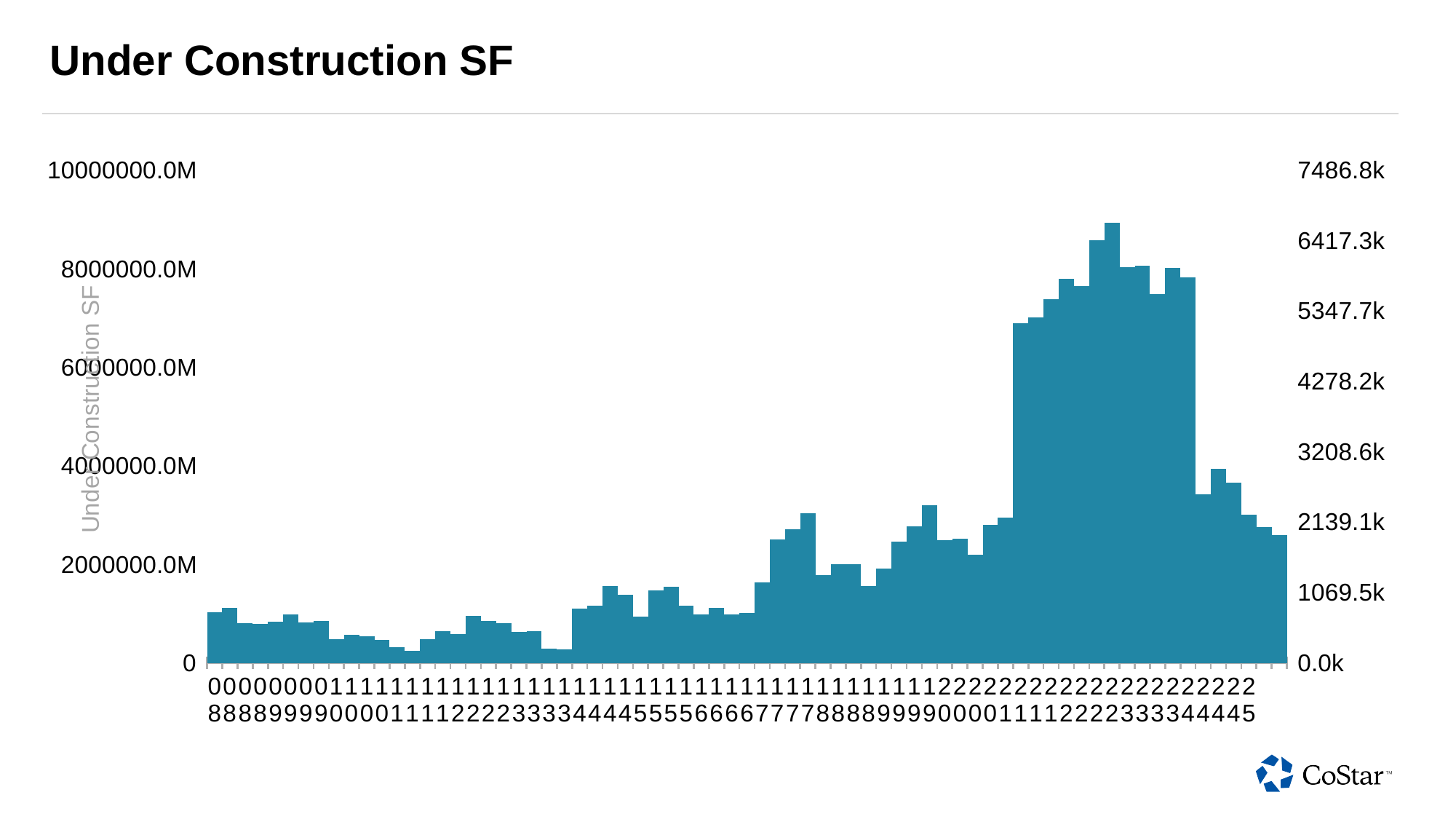
Is the tallest bar located in the left half or the right half of the chart? right half Is the value of the tallest bar greater or less than 8000000.0M on the left axis? greater What is the highest tick label on the left vertical axis? 10000000.0M Comparing the start of the x axis to the end, do the values overall rise or fall? rise Which is larger, the leftmost bar or the rightmost bar? the rightmost bar Is the value of the rightmost bar greater or less than 4000000.0M on the left axis? less What kind of chart is shown on the slide? bar chart What is the title of the chart? Under Construction SF Is the value of the leftmost bar greater or less than 2000000.0M on the left axis? less